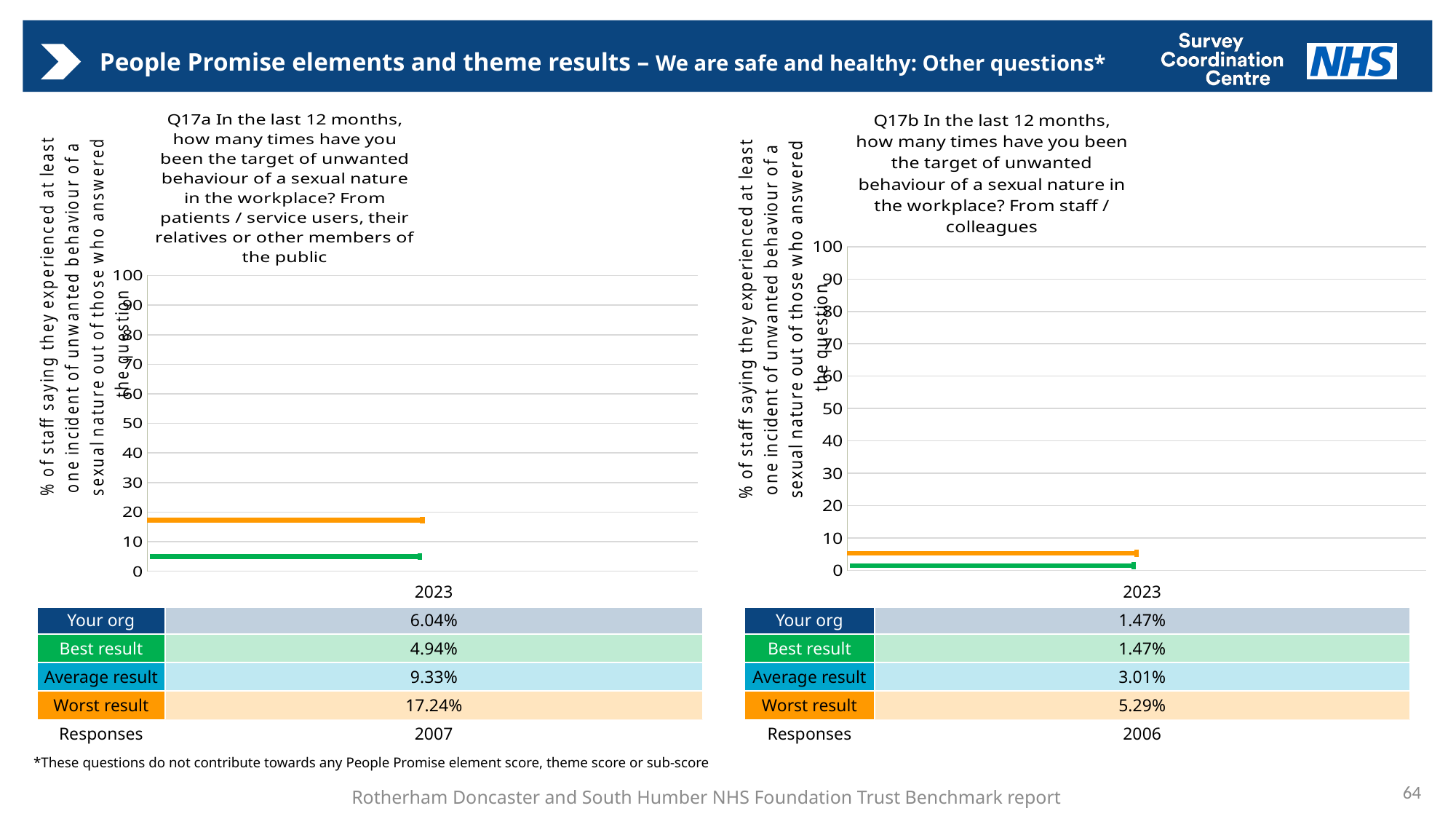
How many years are shown on the x axis of the Q17a chart (left)? 1 In the Q17b chart (right), what is the Best result value? 1.47% In the Q17b chart (right), what is the difference between the Average result and Your org? 1.54% How many responses are listed for the Q17b chart (right)? 2006 In the Q17b chart (right), is the orange Worst result line greater or less than 10 on the axis? less In the Q17a chart (left), what is the Average result value? 9.33% In the Q17b chart (right), what is the Worst result value? 5.29% In the Q17a chart (left), which is larger: Your org or the Average result? Average result In the Q17a chart (left), what is the difference between the Worst result and the Best result? 12.30% In the Q17a chart (left), is the orange Worst result line greater or less than 20 on the axis? less In the Q17a chart (left), what is the Worst result value? 17.24% In the Q17a chart (left), what is the value for Your org in 2023? 6.04%